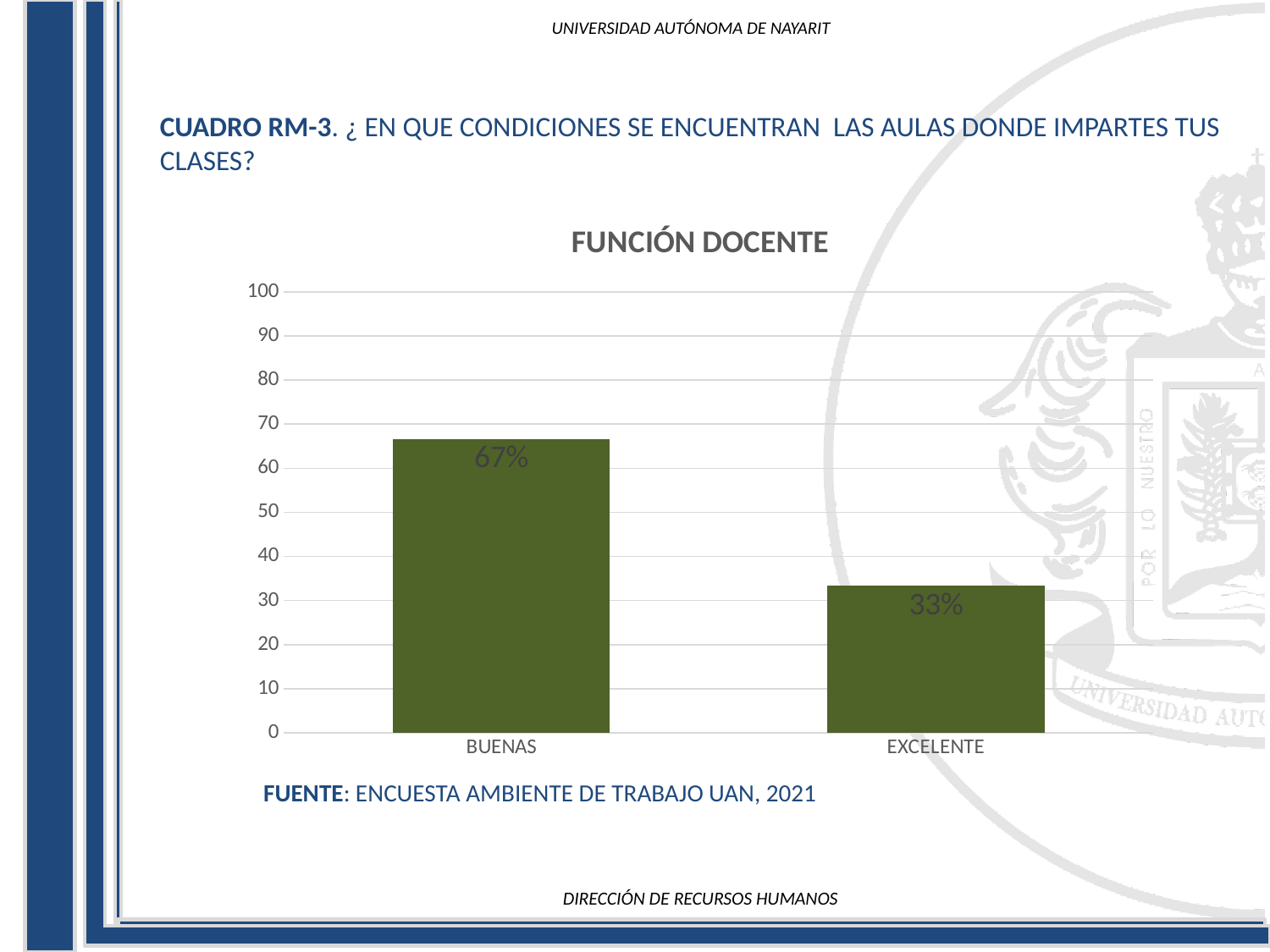
Which is larger, the value for BUENAS or the value for EXCELENTE? BUENAS What is the value for BUENAS? 67% What kind of chart is shown? bar chart Which category has the lowest value? EXCELENTE What is the value for EXCELENTE? 33% How many categories are shown on the x axis? 2 Which category has the highest value? BUENAS Is the value for EXCELENTE greater or less than 40? less Is the value for BUENAS greater or less than 60? greater What is the highest value shown on the y axis? 100 What is the difference between the values for BUENAS and EXCELENTE? 34% What is the title of the chart? FUNCIÓN DOCENTE